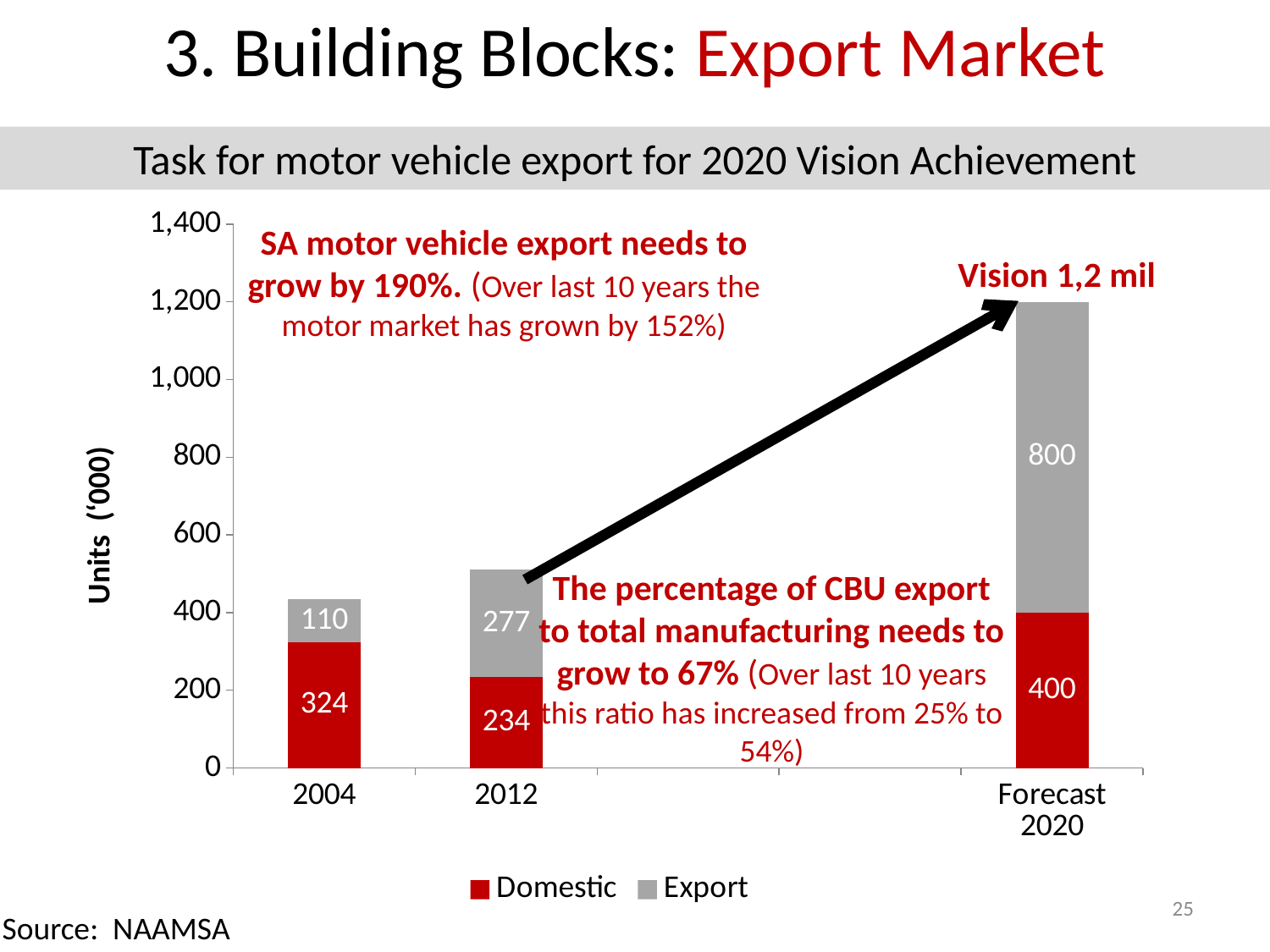
Is the Domestic value for 2004 larger than the Domestic value for 2012? Yes What kind of chart is shown on the slide? Stacked bar chart What is the total of the stacked bar for 2004? 434 What is the difference between the Export values for 2012 and 2004? 167 How many series does the legend list? 2 Which category has the highest Export value? Forecast 2020 What is the Export value for 2012? 277 How many categories are shown on the x axis? 3 What is the Domestic value for Forecast 2020? 400 Which category has the lowest Domestic value? 2012 What is the Export value for Forecast 2020? 800 What is the Domestic value for 2004? 324